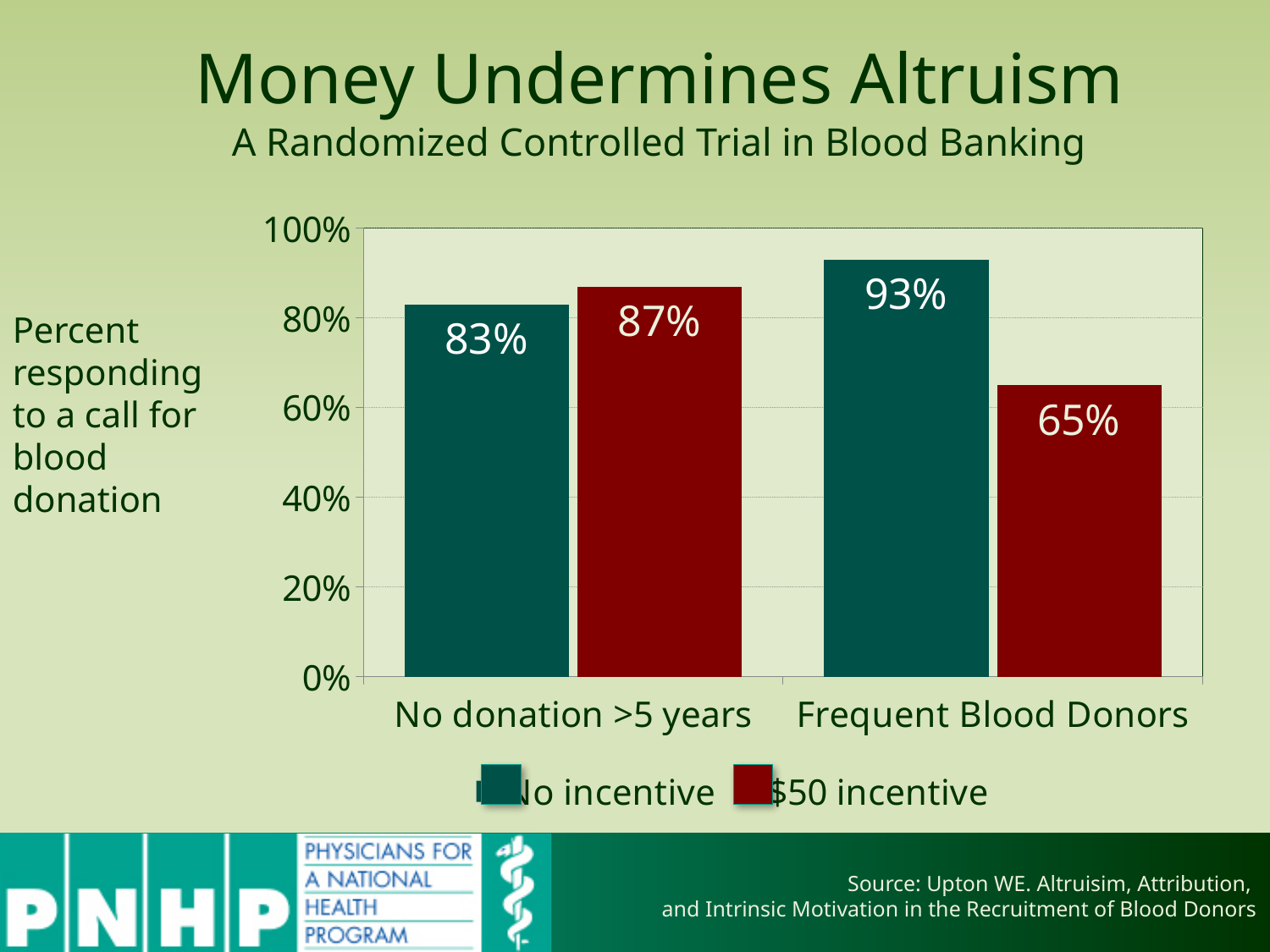
How many donor categories are shown on the x axis? 2 How many series does the legend list? 2 What percent of Frequent Blood Donors responded with no incentive? 93% What is the difference between the $50 incentive and no incentive response rates for the 'No donation >5 years' group? 4% What kind of chart is shown on the slide? Bar chart What percent of the 'No donation >5 years' group responded with no incentive? 83% Which bar shows the lowest response rate? Frequent Blood Donors, $50 incentive (65%) What is the difference between the no incentive and $50 incentive response rates for Frequent Blood Donors? 28% What percent of the 'No donation >5 years' group responded with the $50 incentive? 87% For Frequent Blood Donors, which is larger: the no incentive or the $50 incentive response rate? No incentive Which bar shows the highest response rate? Frequent Blood Donors, No incentive (93%) What percent of Frequent Blood Donors responded with the $50 incentive? 65%